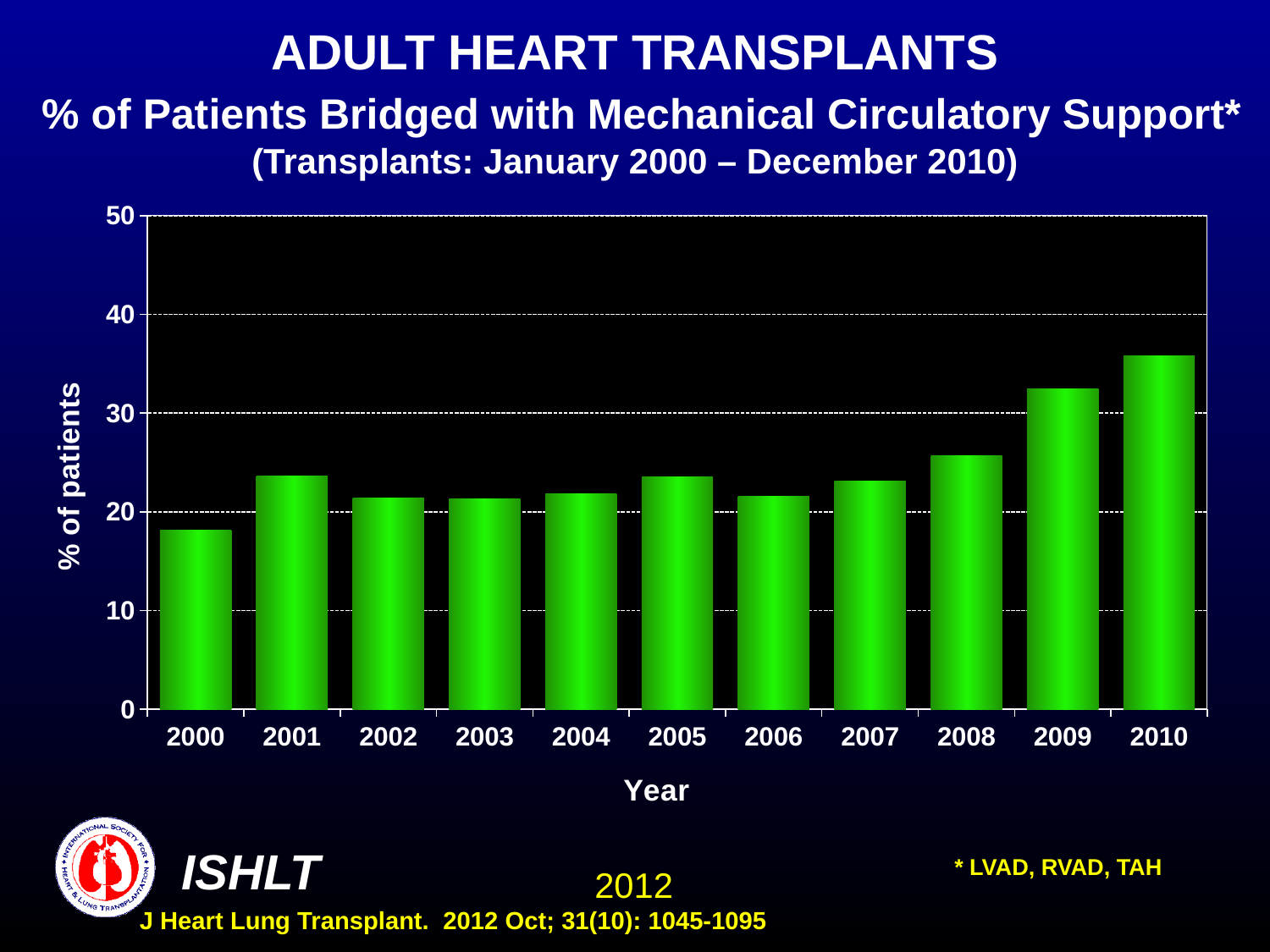
Which year has the larger value, 2009 or 2008? 2009 Which year has the lowest percentage of patients bridged with mechanical circulatory support? 2000 Is the value for 2008 greater or less than 30? less What is the label on the y axis? % of patients Is the value for 2000 greater or less than 20? less Is the value for 2010 greater or less than 30? greater How many years are plotted on the x axis? 11 Which year has the highest percentage of patients bridged with mechanical circulatory support? 2010 Which year has the larger value, 2001 or 2000? 2001 What kind of chart is shown on the slide? Bar chart Do the values generally rise or fall from 2007 to 2010? Rise